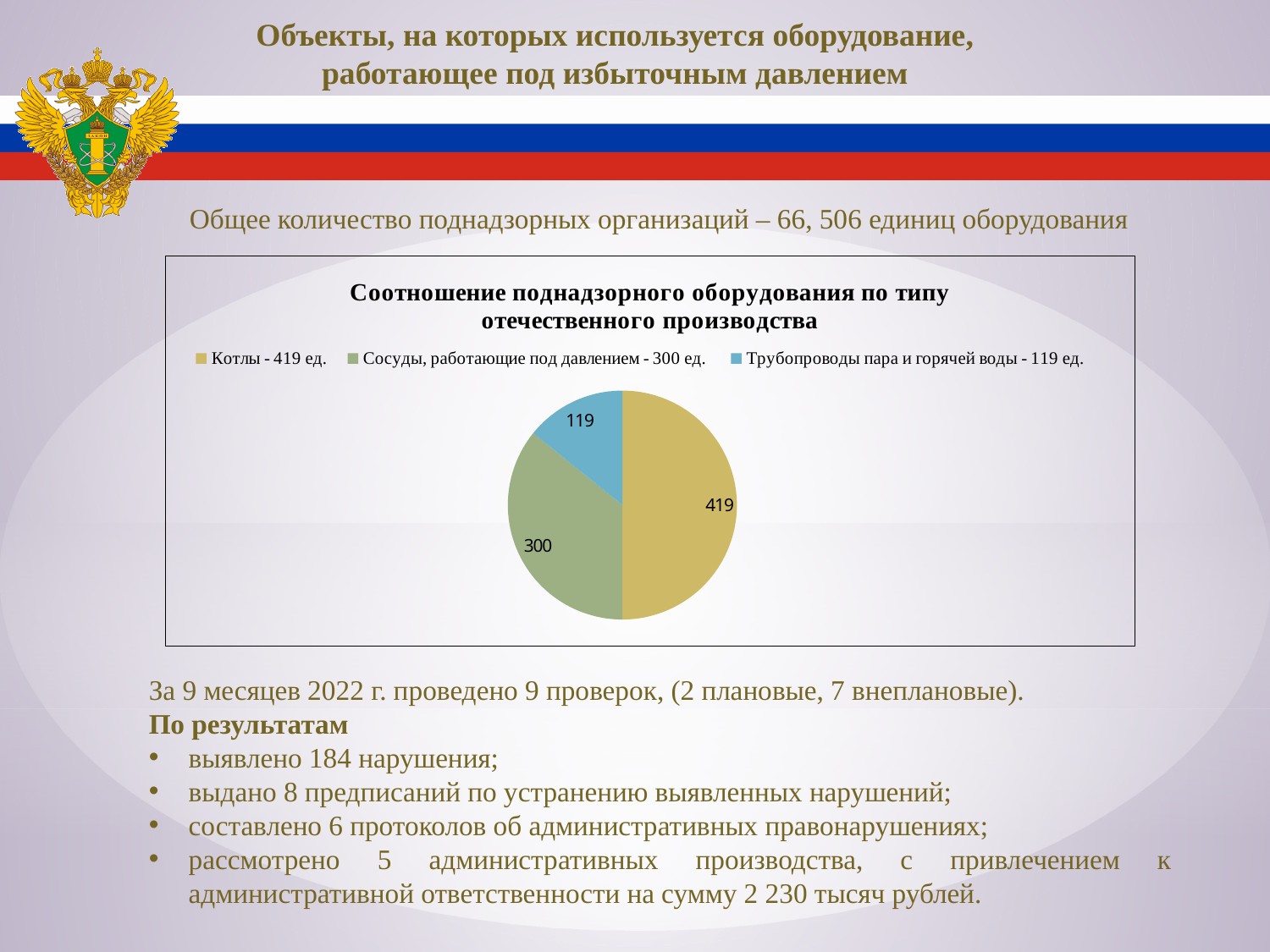
Which category has the largest slice of the pie? Котлы What is the difference between the values for Котлы and Сосуды, работающие под давлением? 119 Which category has the smallest slice of the pie? Трубопроводы пара и горячей воды What is the total of all three slices in the pie chart? 838 What is the value for Сосуды, работающие под давлением? 300 How many slices does the pie chart have? 3 What type of chart is shown on the slide? pie chart How many entries does the chart legend list? 3 What is the value for Трубопроводы пара и горячей воды? 119 What is the title of the chart? Соотношение поднадзорного оборудования по типу отечественного производства What is the value for Котлы in the pie chart? 419 Which is larger: the value for Сосуды, работающие под давлением or for Трубопроводы пара и горячей воды? Сосуды, работающие под давлением